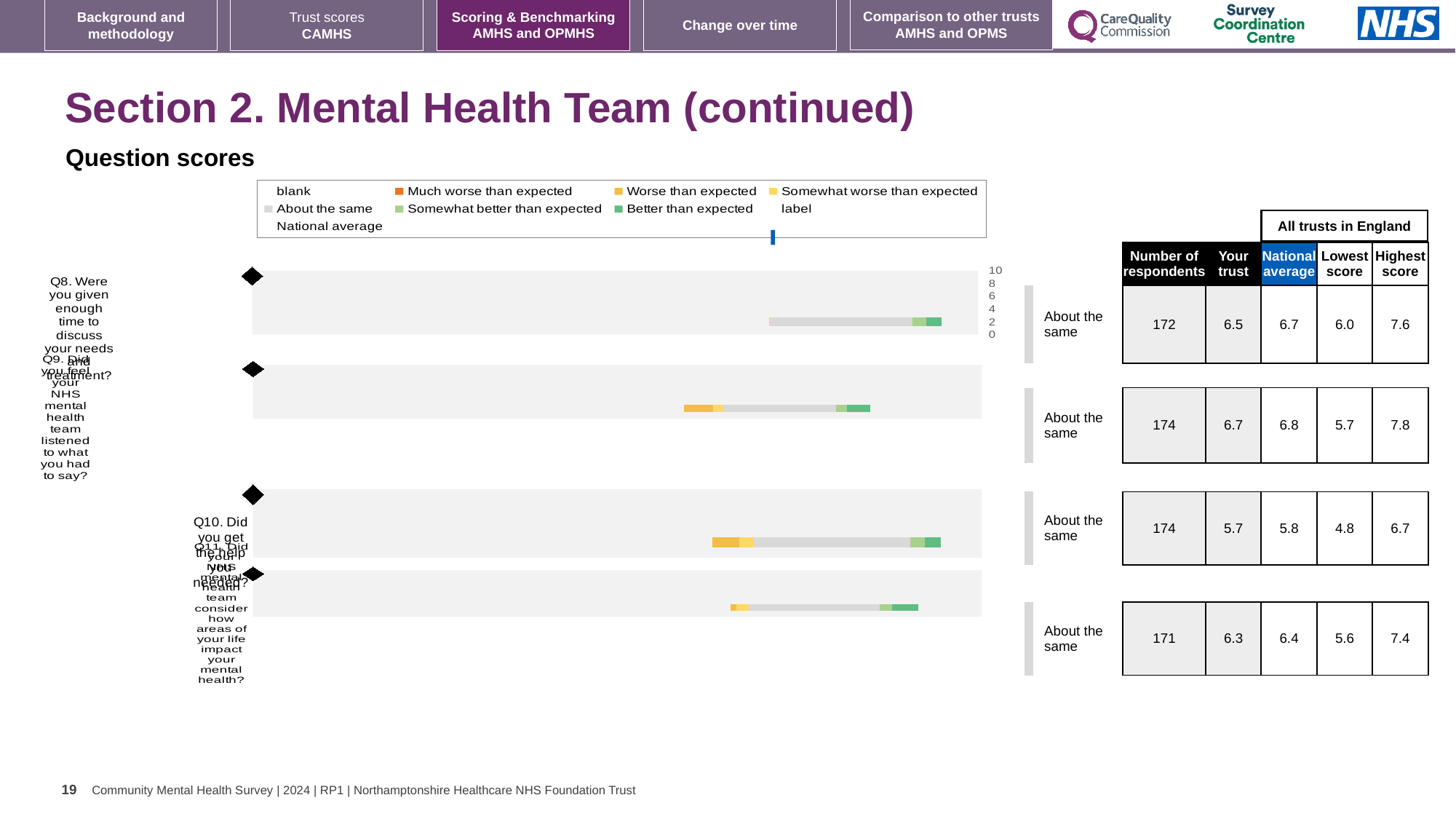
How many questions (categories) are plotted in the question scores chart? 4 In the table beside the chart, is the 'Your trust' score for Q8 larger or smaller than the national average for Q8? smaller What is the highest tick value shown on the axis of the question scores chart? 10 In the table beside the chart, what is the national average for Q10 (the third row)? 5.8 How many entries does the legend of the question scores chart list? 9 In the table beside the chart, which row has the highest 'Highest score' value? Q9 (second row), 7.8 In the table beside the chart, what is the 'Your trust' score for Q9 (the second row)? 6.7 Which legend entry in the question scores chart is shown in orange? Much worse than expected In the table beside the chart, which row has the lowest 'Your trust' score? Q10 (third row), 5.7 In the table beside the chart, how many respondents are listed for Q11 (the fourth row)? 171 What kind of chart is used to show the question scores on this slide? bar chart In the table beside the chart, what is the difference between the highest score and lowest score for Q8 (the first row)? 1.6